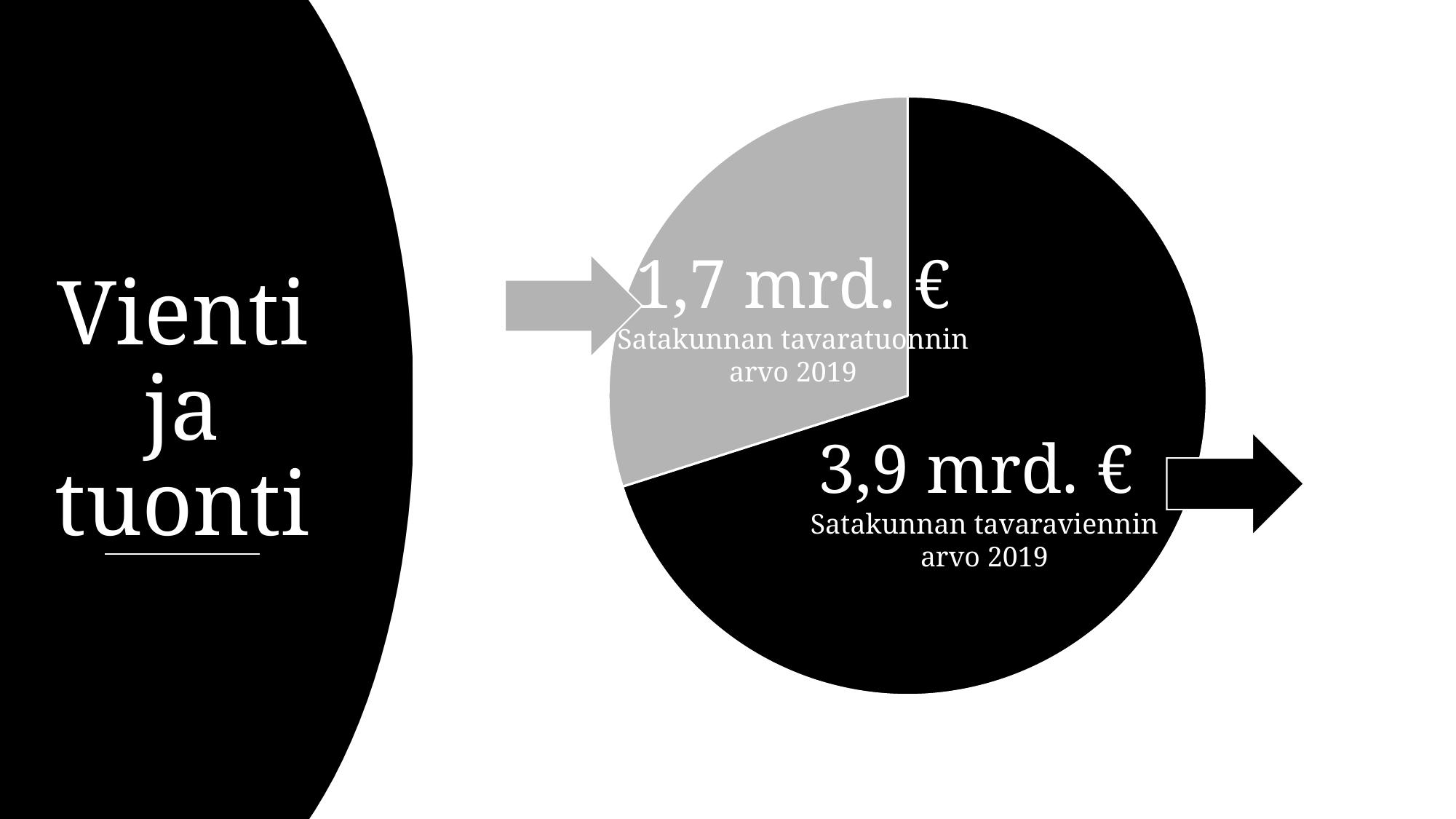
How much larger is Satakunnan tavaraviennin arvo 2019 than Satakunnan tavaratuonnin arvo 2019? 2,3 mrd. € What colour is the slice for Satakunnan tavaratuonnin arvo 2019? grey What is the combined value of the two slices in the pie chart? 5,6 mrd. € Which slice of the pie chart is the smallest? Satakunnan tavaratuonnin arvo 2019 What is the value of Satakunnan tavaraviennin arvo 2019 in the pie chart? 3,9 mrd. € Which slice of the pie chart is the largest? Satakunnan tavaraviennin arvo 2019 What colour is the slice for Satakunnan tavaraviennin arvo 2019? black Which is larger, Satakunnan tavaraviennin arvo 2019 or Satakunnan tavaratuonnin arvo 2019? Satakunnan tavaraviennin arvo 2019 What kind of chart is shown on the slide? pie chart How many slices does the pie chart have? 2 What is the value of Satakunnan tavaratuonnin arvo 2019 in the pie chart? 1,7 mrd. €